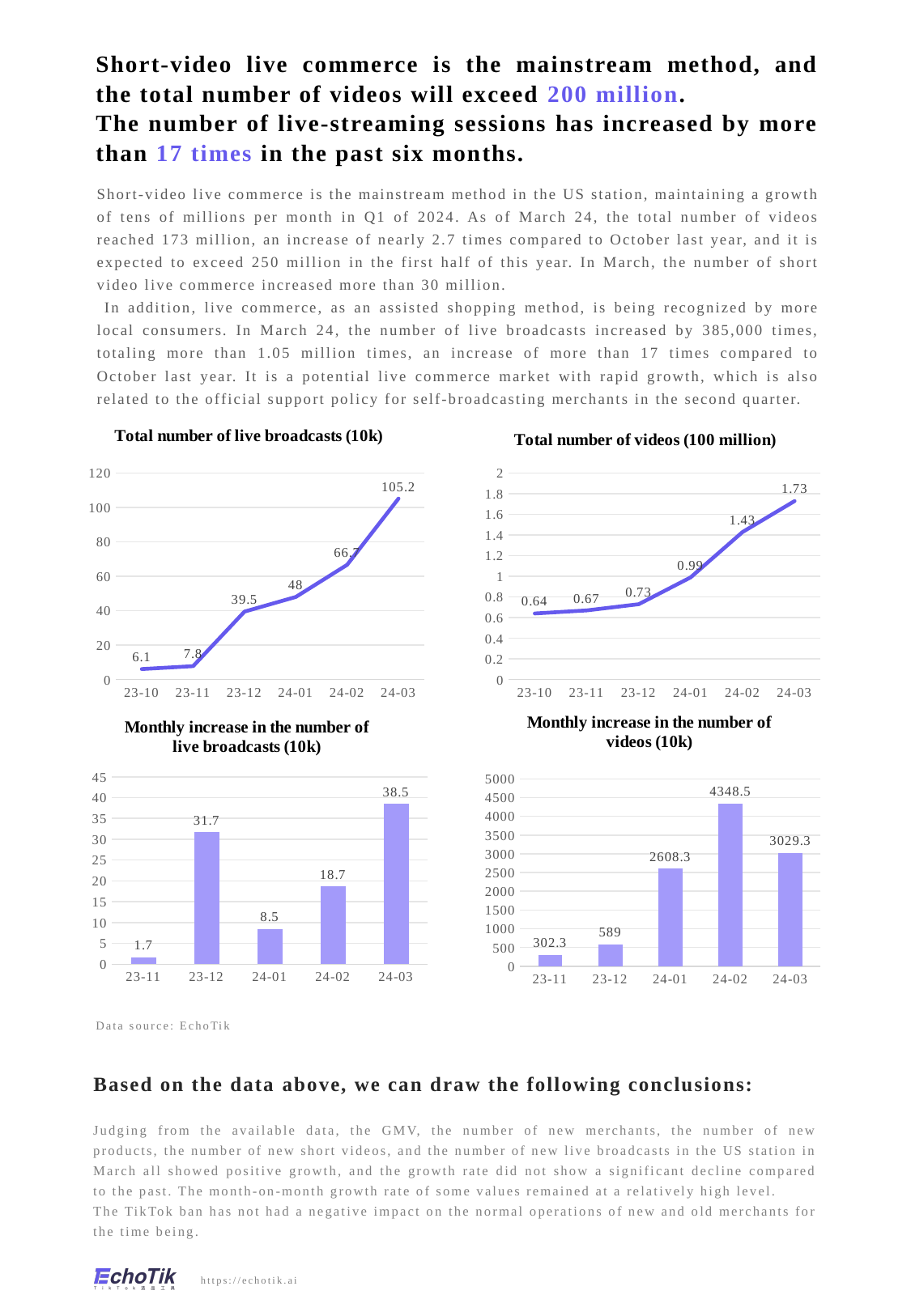
In the 'Total number of videos (100 million)' chart, what is the value for 24-01? 0.99 In the 'Monthly increase in the number of live broadcasts (10k)' chart, which is larger, the value for 23-12 or the value for 24-02? 23-12 How many months are shown in the 'Monthly increase in the number of videos (10k)' chart? 5 In the 'Total number of live broadcasts (10k)' chart, what is the value for 24-03? 105.2 What kind of chart is 'Monthly increase in the number of videos (10k)'? Bar chart In the 'Total number of live broadcasts (10k)' chart, what is the value for 23-12? 39.5 What kind of chart is 'Total number of live broadcasts (10k)'? Line chart In the 'Monthly increase in the number of live broadcasts (10k)' chart, which month has the highest value? 24-03 In the 'Total number of videos (100 million)' chart, which month has the lowest value? 23-10 In the 'Total number of videos (100 million)' chart, what is the difference between the values for 24-03 and 23-10? 1.09 In the 'Monthly increase in the number of videos (10k)' chart, what is the value for 24-02? 4348.5 In the 'Monthly increase in the number of live broadcasts (10k)' chart, what is the value for 24-01? 8.5